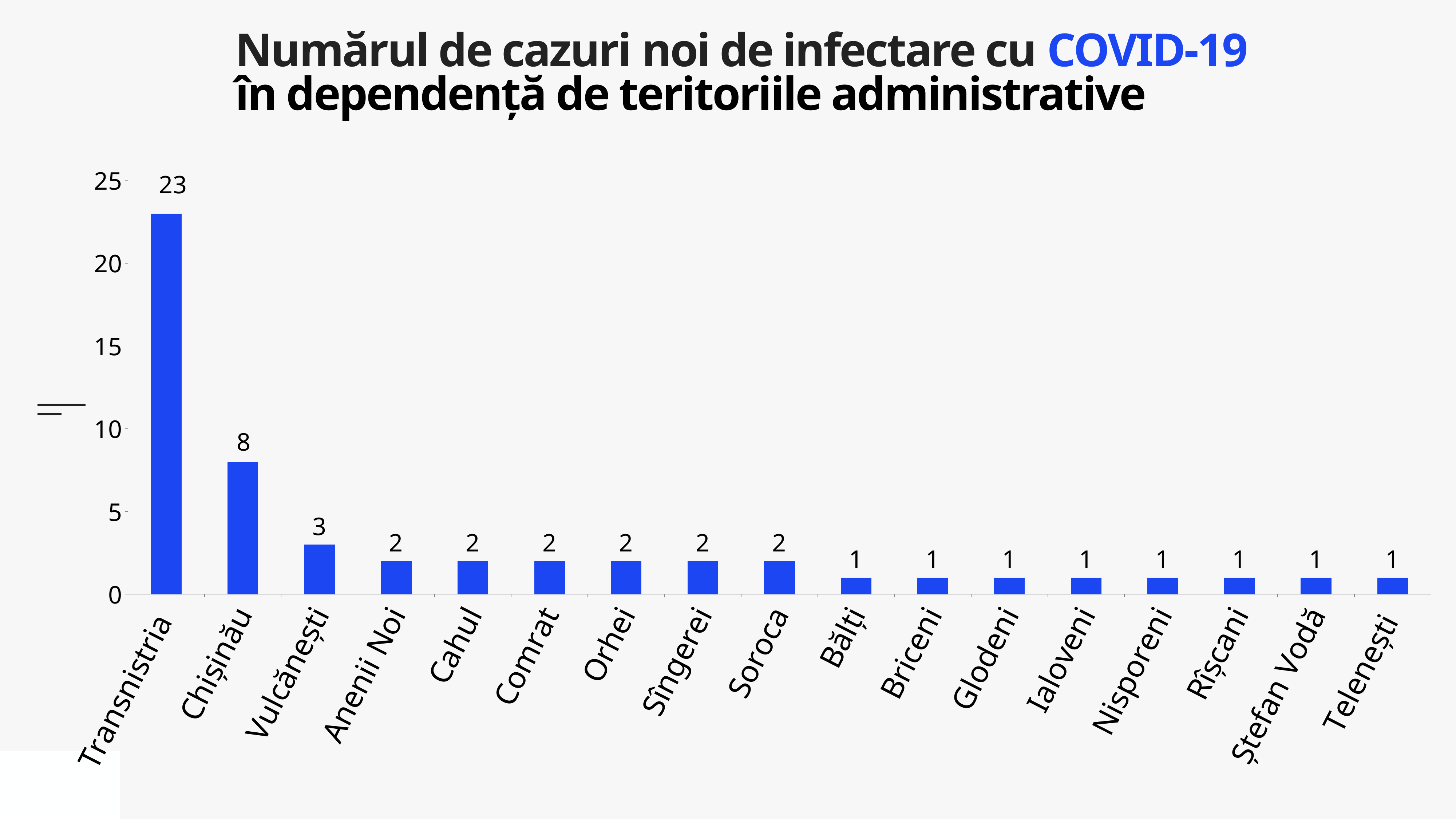
What is the difference between the values for Transnistria and Chișinău? 15 Is the value for Transnistria greater or less than 20? greater What is the value for Vulcănești? 3 What is the value for Chișinău? 8 What kind of chart is shown on the slide? bar chart How many new COVID-19 cases are shown for Transnistria? 23 What is the difference between the values for Chișinău and Vulcănești? 5 Which territory has the highest number of new cases? Transnistria Do the values rise or fall from left to right along the x axis? fall Which is larger, the value for Cahul or the value for Bălți? Cahul What is the value for Soroca? 2 How many territories are shown on the x axis? 17